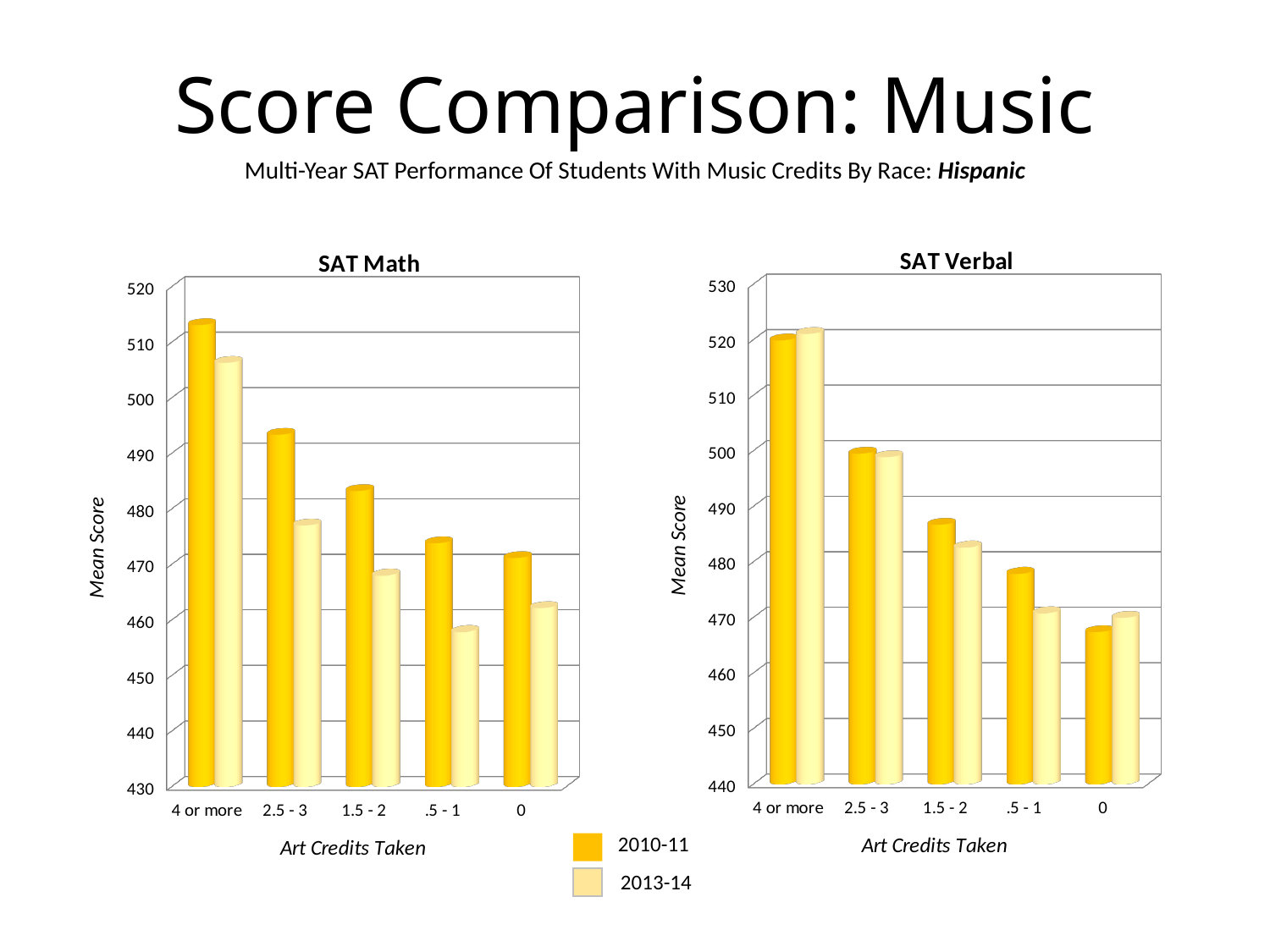
In the SAT Verbal chart, is the 2010-11 value for 0 greater or less than 480? less What kind of chart is the SAT Math chart? bar chart In the SAT Math chart, which category has the highest 2010-11 value? 4 or more In the SAT Math chart, is the 2013-14 value for .5 - 1 greater or less than 470? less In the SAT Verbal chart, which category has the lowest 2010-11 value? 0 In the SAT Verbal chart, for the .5 - 1 category, which series has the larger value, 2010-11 or 2013-14? 2010-11 In the SAT Verbal chart, do the 2010-11 values rise or fall from left to right along the x axis? fall What is the label on the y axis of the SAT Math chart? Mean Score In the SAT Math chart, is the 2010-11 value for 4 or more greater or less than 500? greater How many categories are shown on the x axis of the SAT Verbal chart? 5 In the SAT Math chart, for the 2.5 - 3 category, which series has the larger value, 2010-11 or 2013-14? 2010-11 How many series does the legend list? 2